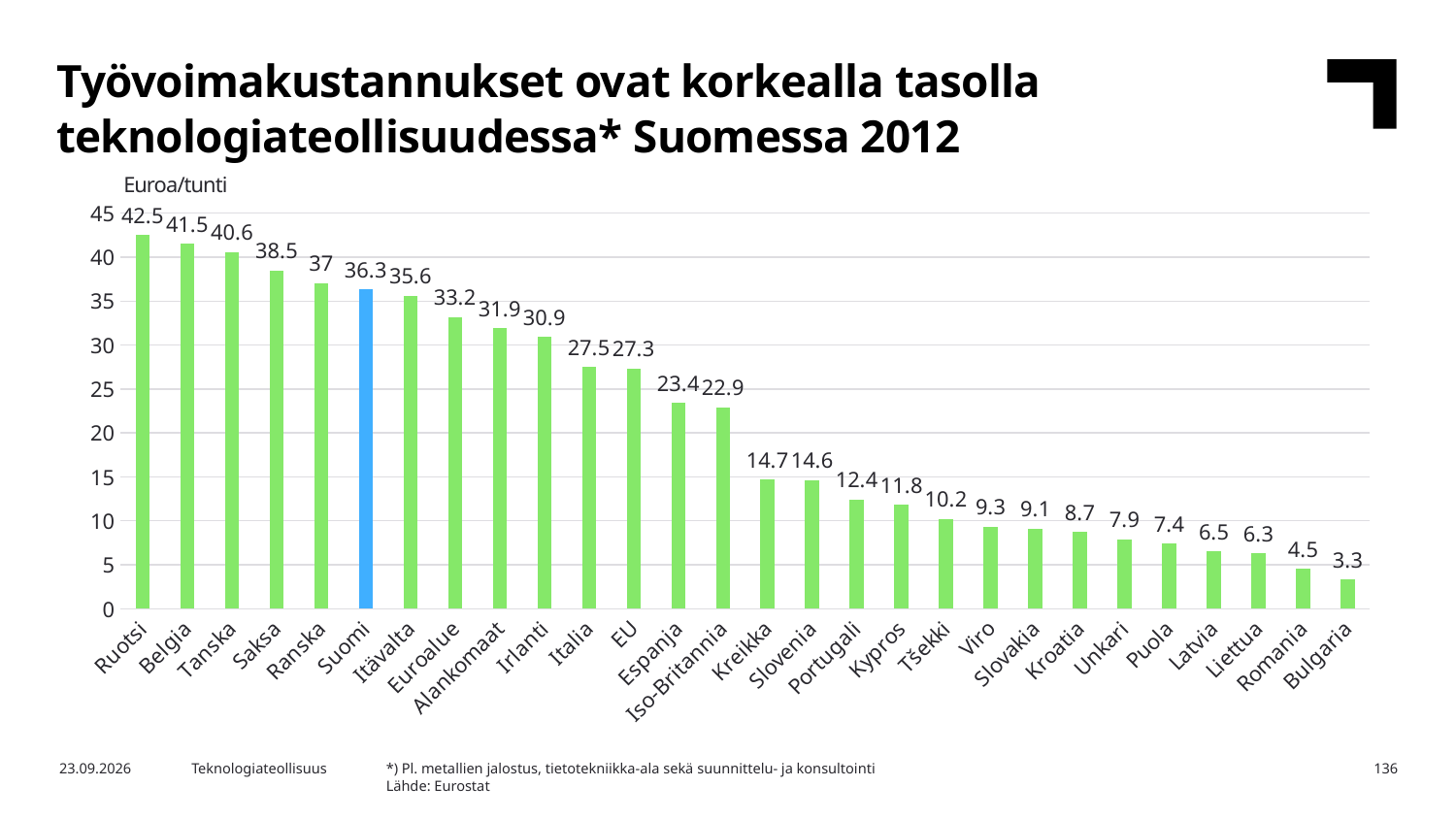
What is the difference between the values for Ruotsi and Suomi? 6.2 How many countries or regions are shown on the x axis? 28 Do the values rise or fall from left to right along the x axis? Fall Which country has the lowest labour cost per hour? Bulgaria Which is larger, the value for Saksa or the value for Itävalta? Saksa What is the difference between the values for EU and Euroalue? 5.9 What is the value for Alankomaat? 31.9 What kind of chart is shown on the slide? Bar chart Which country has the highest labour cost per hour? Ruotsi What is the value for Kreikka? 14.7 What unit is shown above the y axis? Euroa/tunti What is the value for Suomi? 36.3